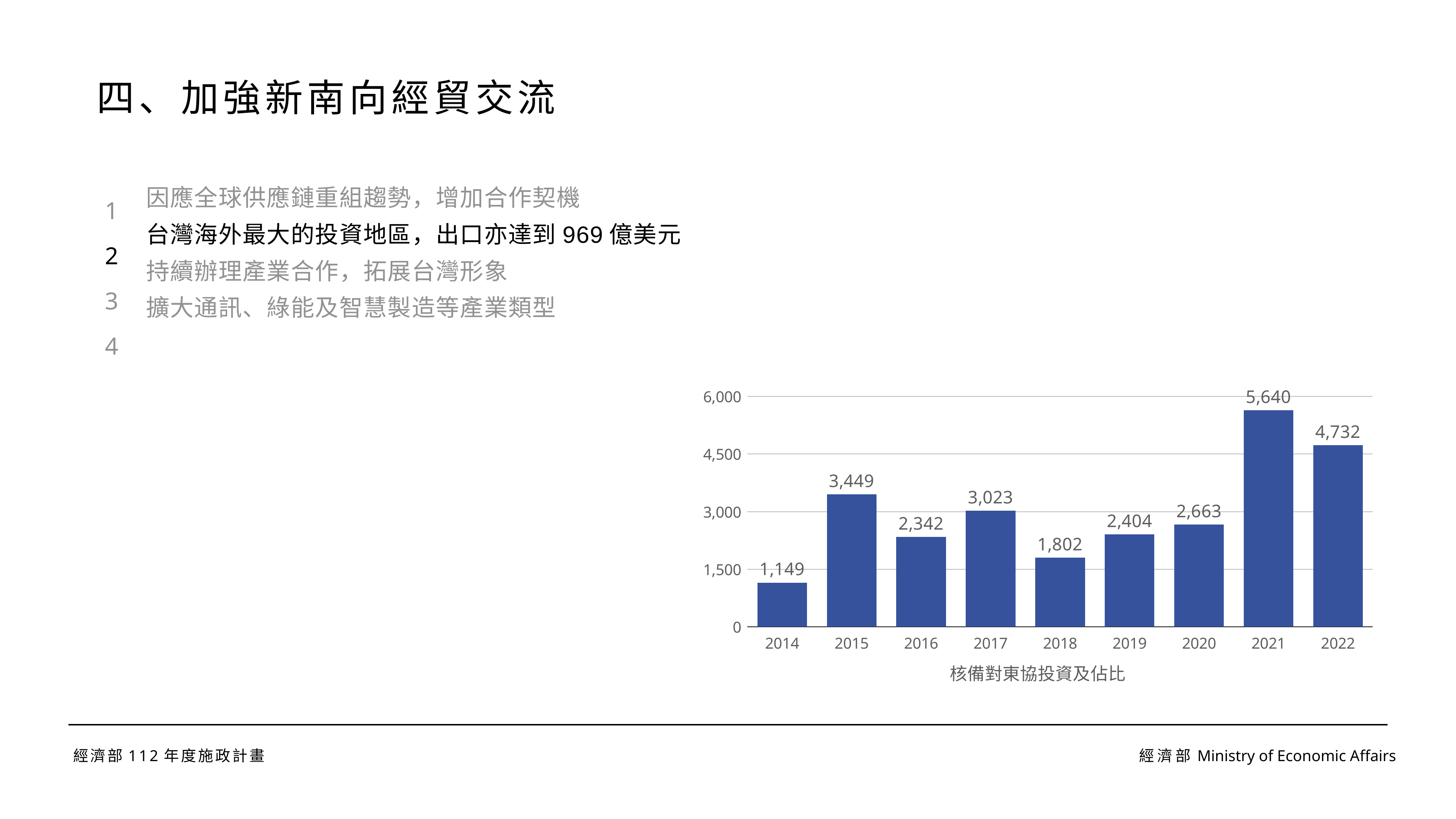
What is the value for 2014? 1,149 Which year has the lowest value? 2014 What is the value for 2018? 1,802 Which year has the highest value? 2021 What is the difference between the values for 2015 and 2016? 1,107 Which is larger, the value for 2017 or the value for 2020? 2017 What is the value for 2022? 4,732 What is the difference between the values for 2021 and 2022? 908 Is the value for 2019 greater or less than 3,000? less How many years are shown on the x axis? 9 What is the title shown below the chart? 核備對東協投資及佔比 What kind of chart is shown on the slide? bar chart